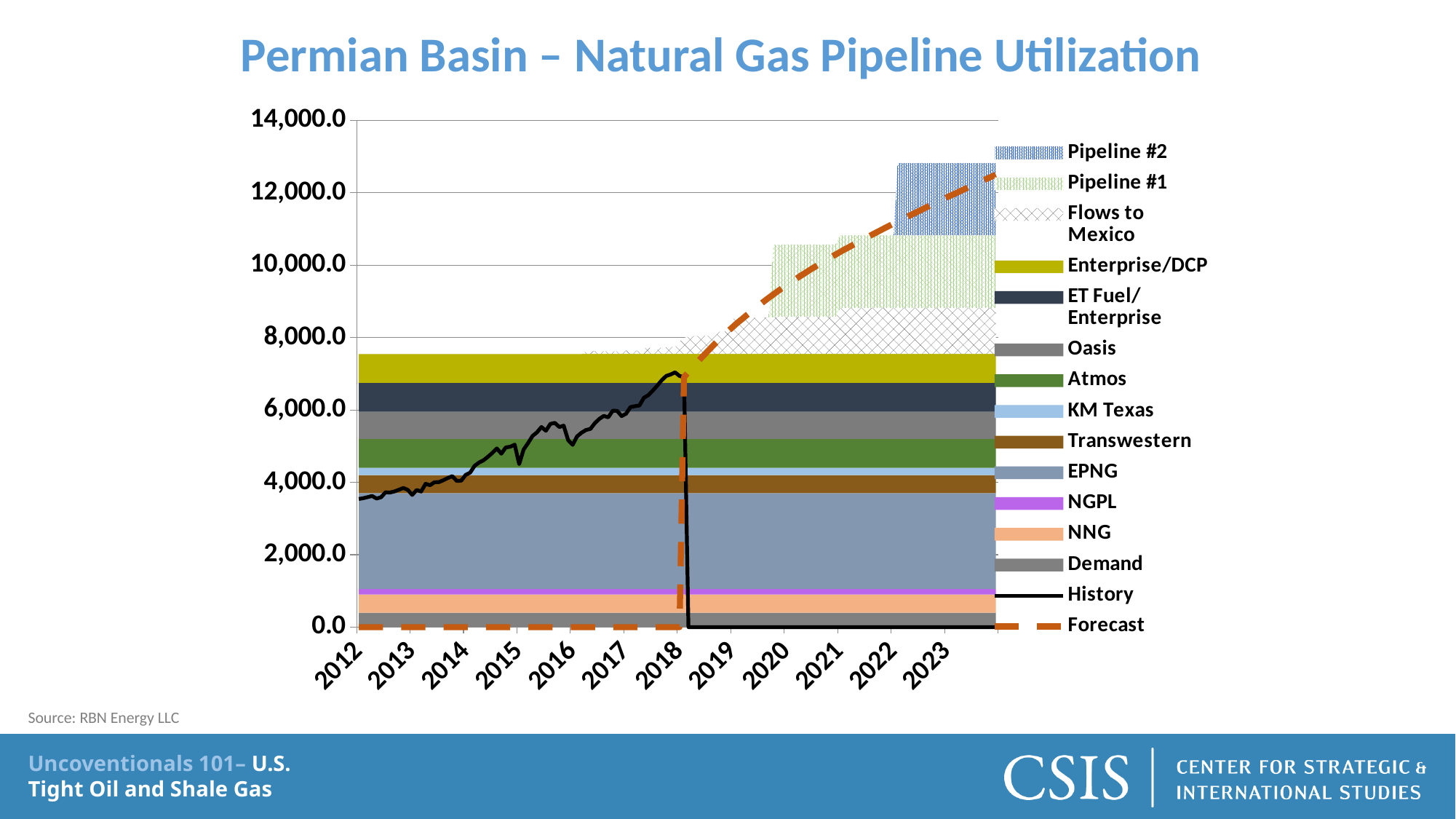
Which legend entry occupies the thickest band in the stacked area? EPNG How many years are labelled along the x axis? 12 What kind of chart is shown on the slide? Stacked area chart Is the Forecast value at the end of 2023 greater or less than 12,000.0? greater What is the first year shown on the x axis? 2012 Does the Forecast line rise or fall between 2018 and 2023? Rise What is the last year shown on the x axis? 2023 Is the History value at the start of 2018 greater or less than 6,000.0? greater Is the History value at the start of 2012 greater or less than 4,000.0? less What is the highest value shown on the y axis? 14,000.0 Does the History line rise or fall between 2012 and 2018? Rise How many entries does the chart legend list? 15